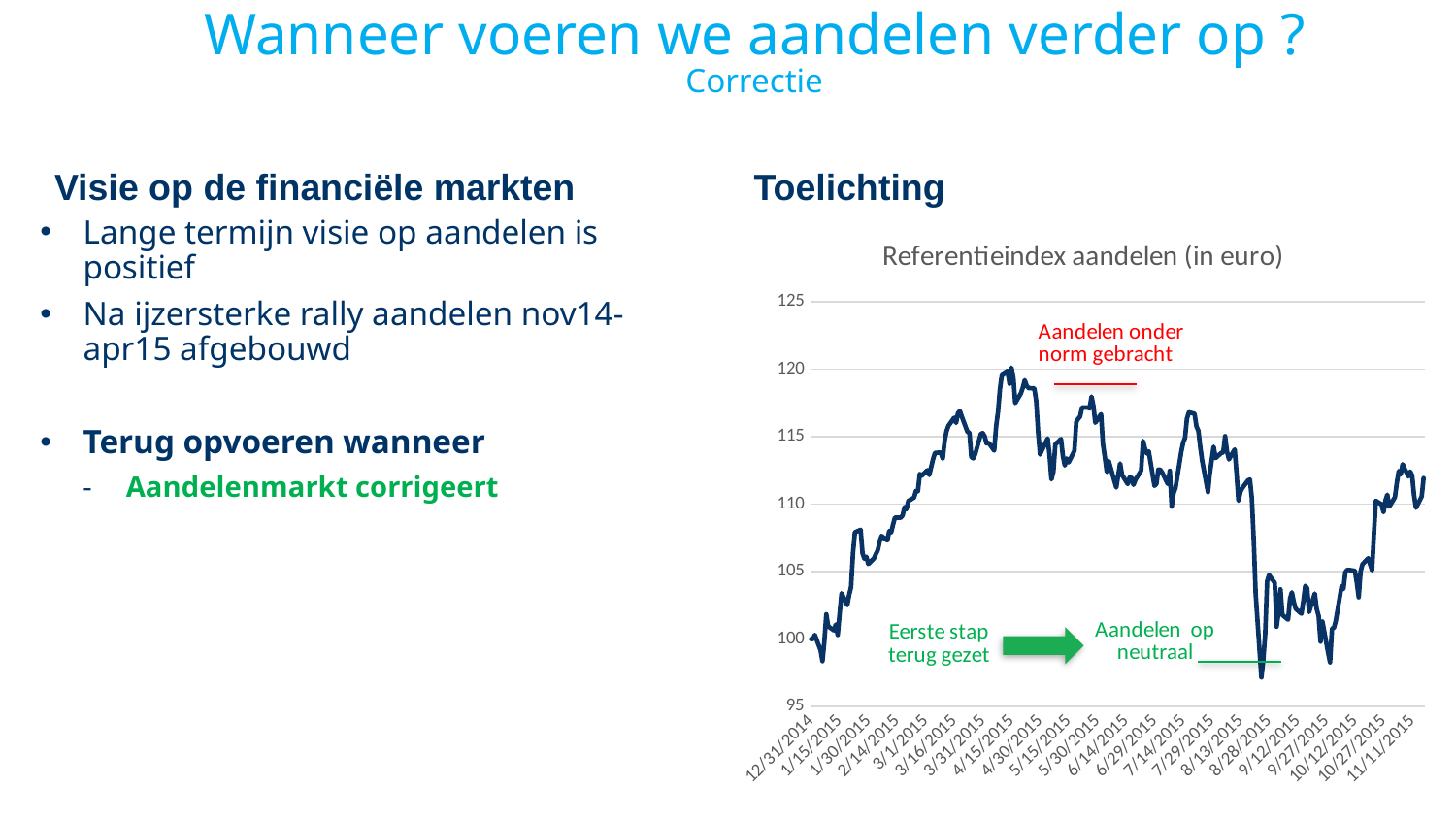
Is the value of the Referentieindex aandelen at 11/11/2015 greater or less than 105? greater Does the Referentieindex aandelen rise or fall between 12/31/2014 and 4/15/2015? rise Is the lowest value of the Referentieindex aandelen around 8/28/2015 greater or less than 100? less How many data series are plotted in the chart? 1 What type of chart is shown on the slide? line chart Does the Referentieindex aandelen rise or fall between 4/30/2015 and 8/28/2015? fall How many tick labels are shown on the y axis of the chart? 7 What is the highest value shown on the y axis of the chart? 125 What is the title of the chart? Referentieindex aandelen (in euro) Is the value of the Referentieindex aandelen around 4/15/2015 greater or less than 115? greater Which is higher: the Referentieindex aandelen around 4/15/2015 or around 8/28/2015? around 4/15/2015